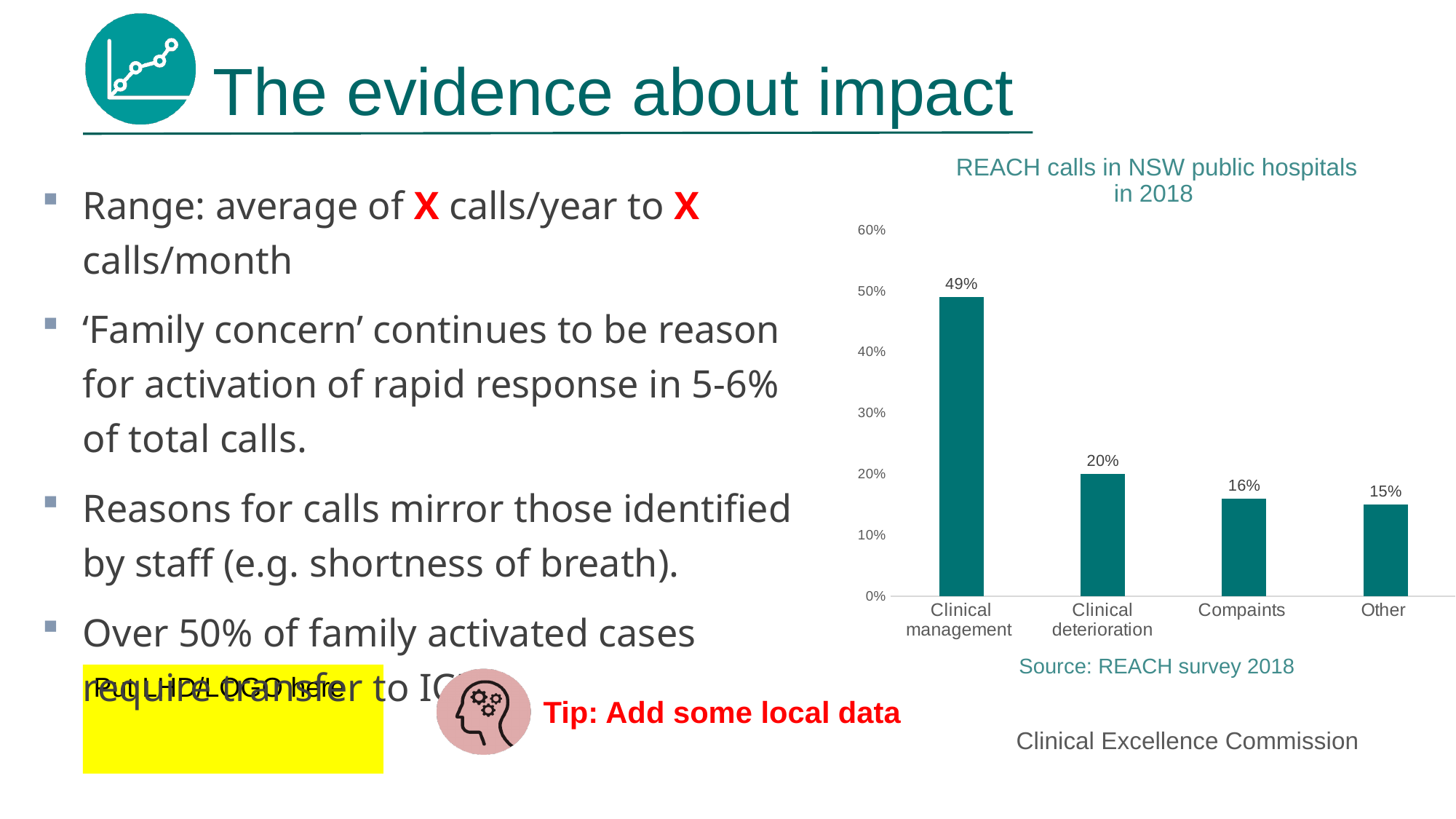
Which is larger, the value for Clinical deterioration or the value for Compaints? Clinical deterioration What is the value for Clinical deterioration? 20% Which category has the highest value? Clinical management What is the value for Clinical management? 49% Is the value for Clinical management greater or less than 40%? greater How many categories are shown on the chart? 4 What is the difference between the values for Clinical management and Clinical deterioration? 29% What kind of chart is shown on the slide? bar chart What is the value for Compaints? 16% What is the value for Other? 15% Which category has the lowest value? Other What is the title of the chart? REACH calls in NSW public hospitals in 2018